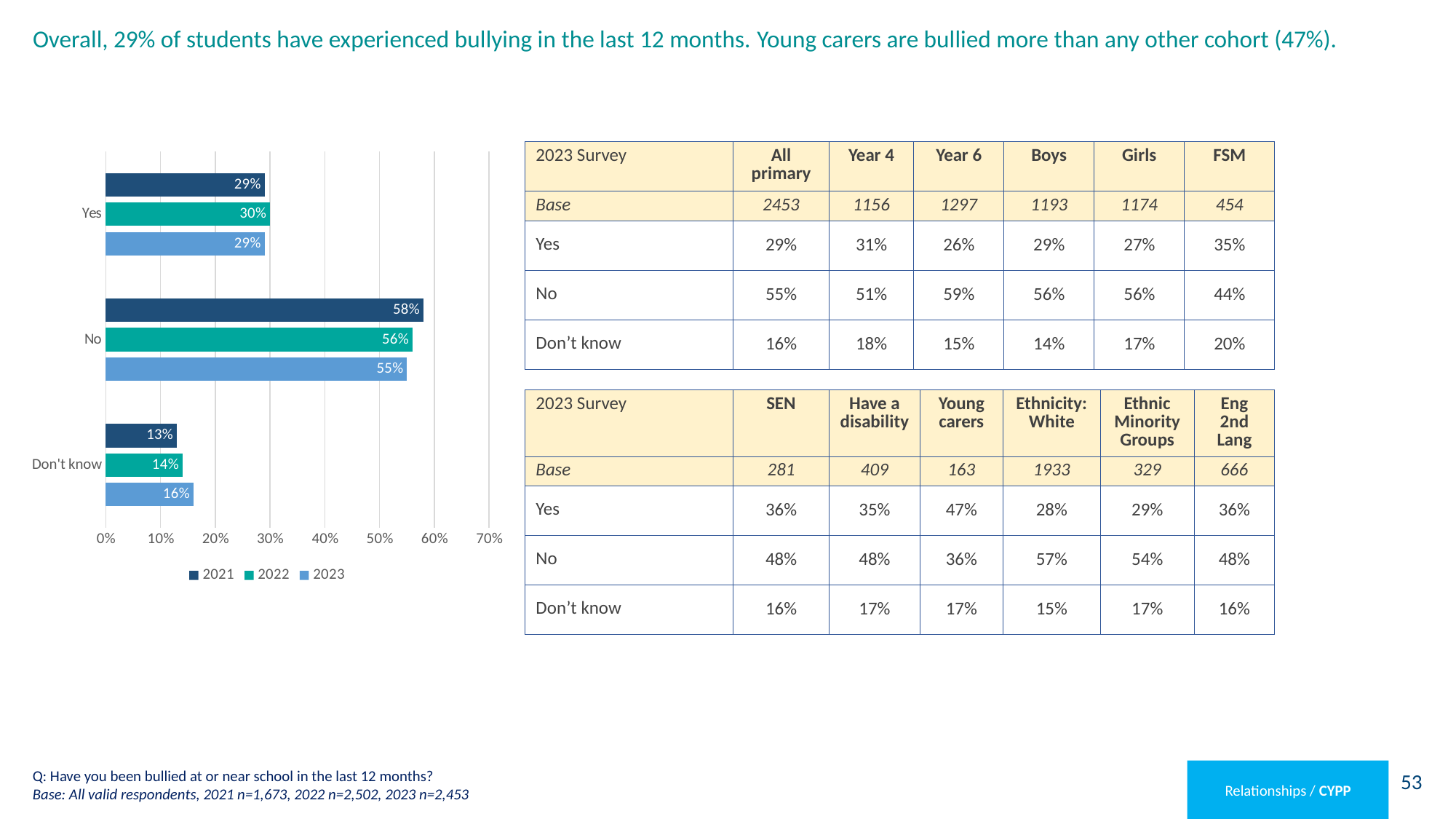
What is the 2023 value for 'No' in the bar chart? 55% How many series does the legend of the bar chart list? 3 How many categories are shown on the y axis of the bar chart? 3 Which category has the lowest value for 2023 in the bar chart? Don't know Is the 2022 value for 'No' in the bar chart greater or less than 50%? greater What is the 2022 value for 'Yes' in the bar chart? 30% What is the 2021 value for 'Don't know' in the bar chart? 13% Which years are listed in the legend of the bar chart? 2021, 2022, 2023 What kind of chart is shown on the left of the slide? Bar chart Which category has the highest value for 2021 in the bar chart? No What is the difference between the 2021 and 2023 values for 'No' in the bar chart? 3% Which is larger in the bar chart: the 2022 value for 'Don't know' or the 2023 value for 'Don't know'? 2023